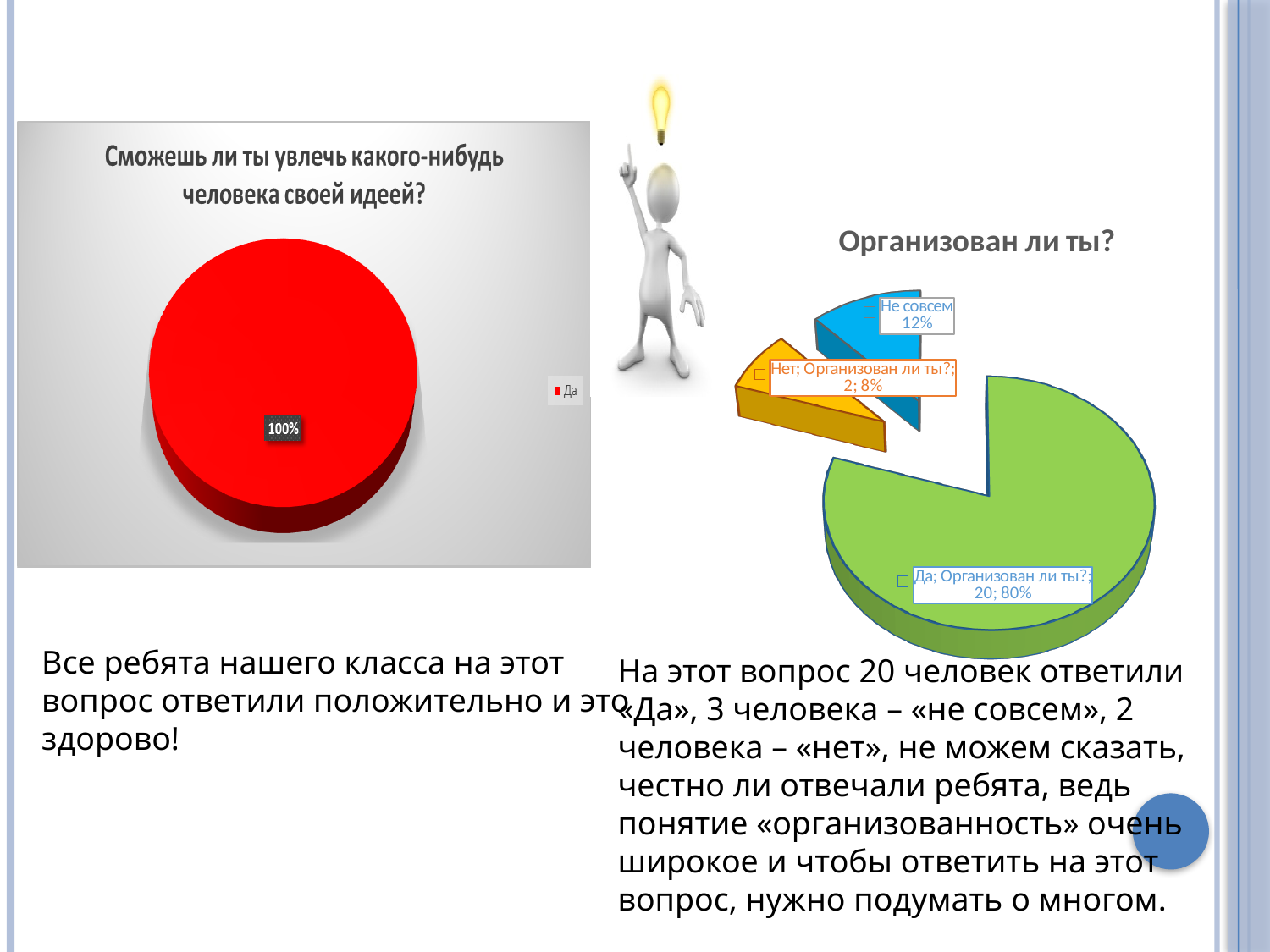
In the chart titled "Организован ли ты?", which is larger, the "Не совсем" slice or the "Нет" slice? Не совсем In the chart titled "Сможешь ли ты увлечь какого-нибудь человека своей идеей?", what share of the pie does the "Да" slice take? 100% What kind of chart is the chart titled "Организован ли ты?"? pie chart In the chart titled "Организован ли ты?", which slice is the largest? Да In the chart titled "Сможешь ли ты увлечь какого-нибудь человека своей идеей?", how many entries does the legend list? 1 In the chart titled "Организован ли ты?", how many slices does the pie have? 3 In the chart titled "Организован ли ты?", what share of the pie does the "Нет" slice take? 8% In the chart titled "Организован ли ты?", which slice is the smallest? Нет In the chart titled "Организован ли ты?", how many people answered "Да"? 20 In the chart titled "Организован ли ты?", how many people answered "Нет"? 2 In the chart titled "Организован ли ты?", what share of the pie does the "Да" slice take? 80%